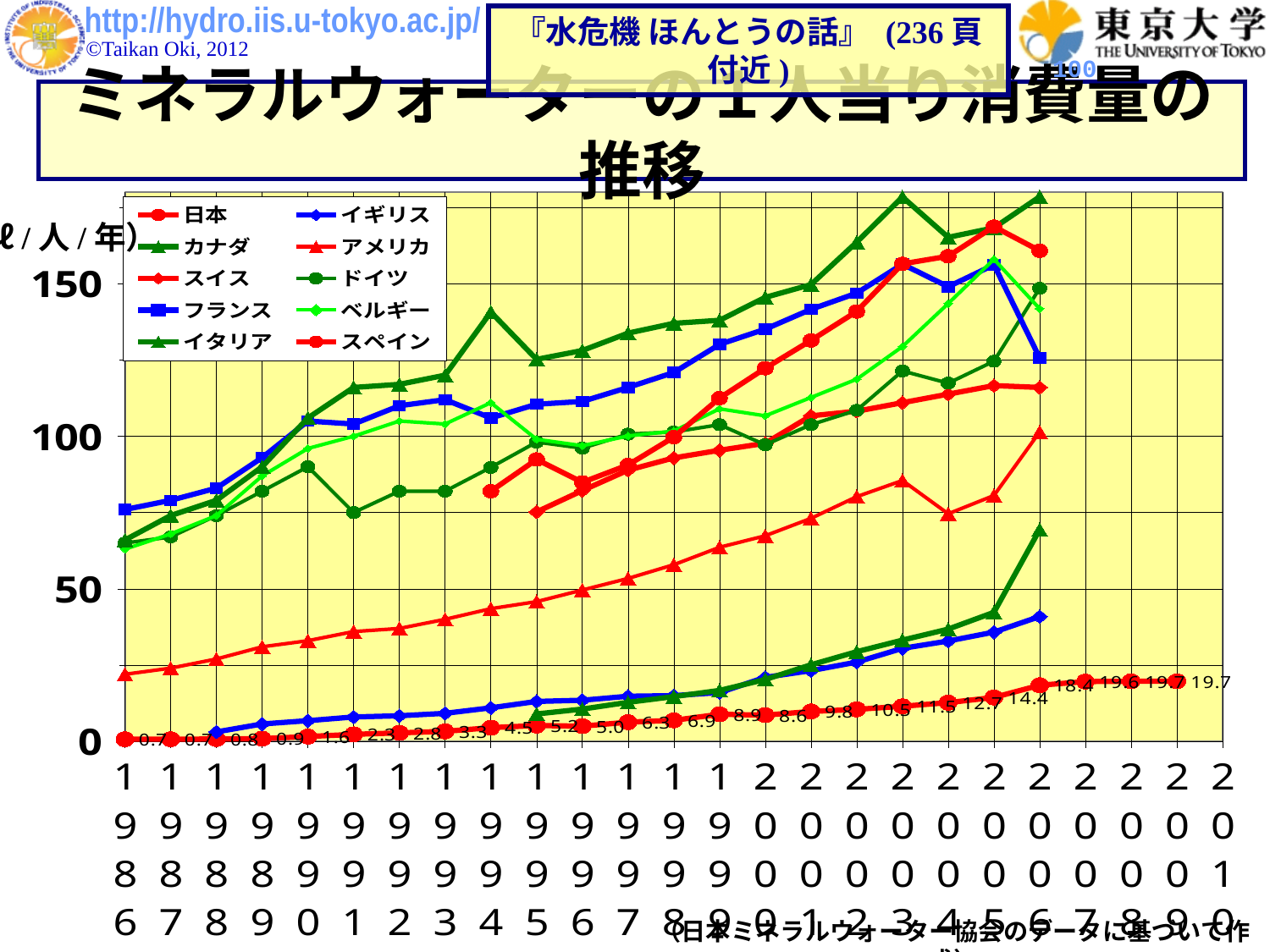
What is the highest data label shown for the 日本 series? 19.7 What is the first data label shown for 日本 (at 1986)? 0.7 What kind of chart is shown on the slide? line chart How many series does the legend list? 10 What is the data label for 日本 in 2005? 14.4 What is the lowest data label shown for the 日本 series? 0.7 Is the value for フランス in 1986 greater or less than 50? greater Does the 日本 series rise or fall over the years shown? rise What is the difference between the last labeled value (19.7) and the first labeled value (0.7) for 日本? 19.0 Which series has the lowest values across the whole chart? 日本 What unit is shown on the y axis of the chart? ℓ/人/年 Is the value for アメリカ in 1986 greater or less than 50? less